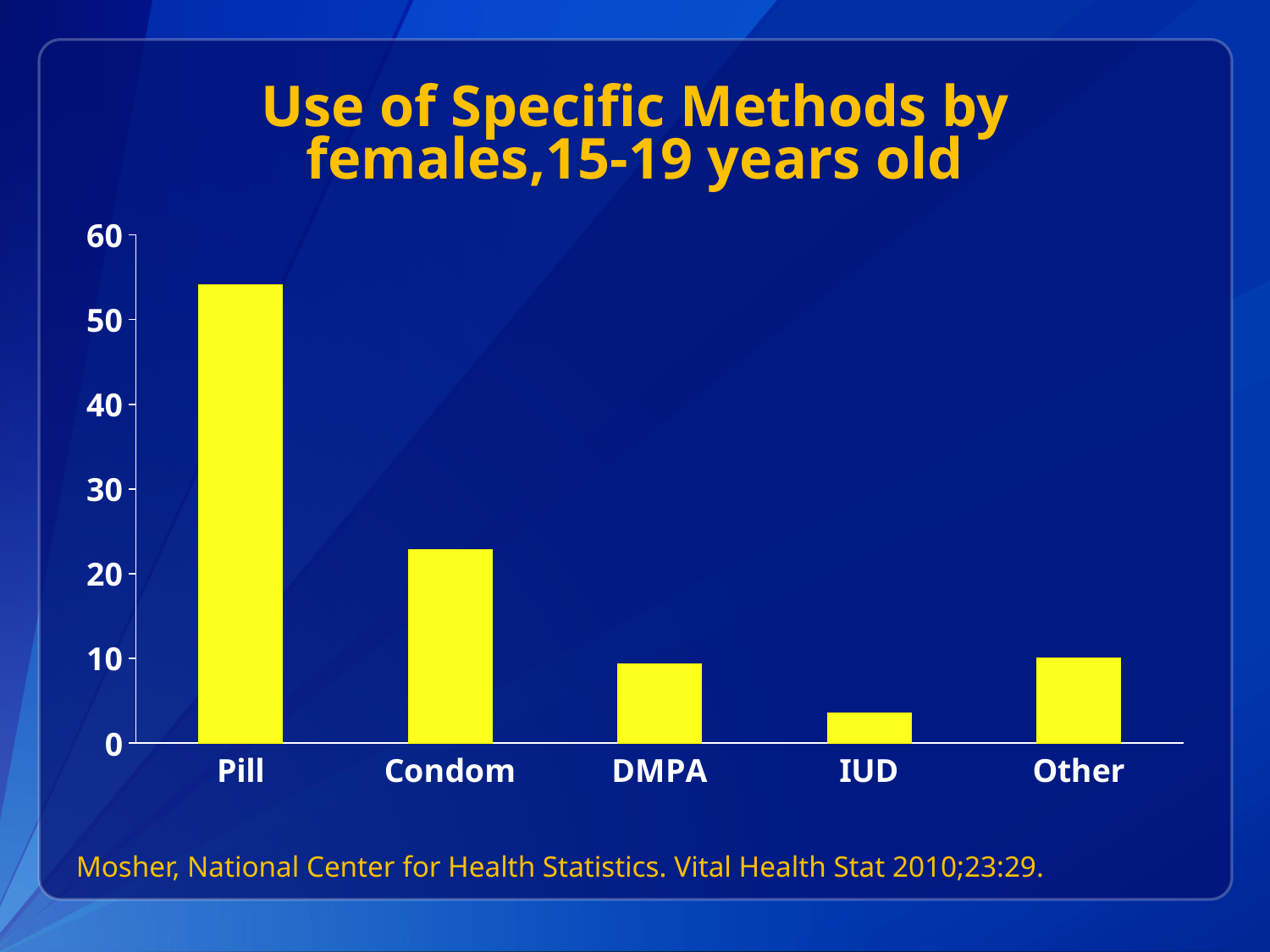
Is the value for IUD greater or less than 10? less Is the value for Condom greater or less than 30? less How many categories are shown on the x axis of the chart? 5 What kind of chart is shown on the slide? bar chart What is the title of the chart? Use of Specific Methods by females,15-19 years old Which is larger, the value for Condom or the value for IUD? Condom Which is larger, the value for Pill or the value for Condom? Pill Is the value for Pill greater or less than 50? greater Which method has the highest value in the chart? Pill Which method has the lowest value in the chart? IUD